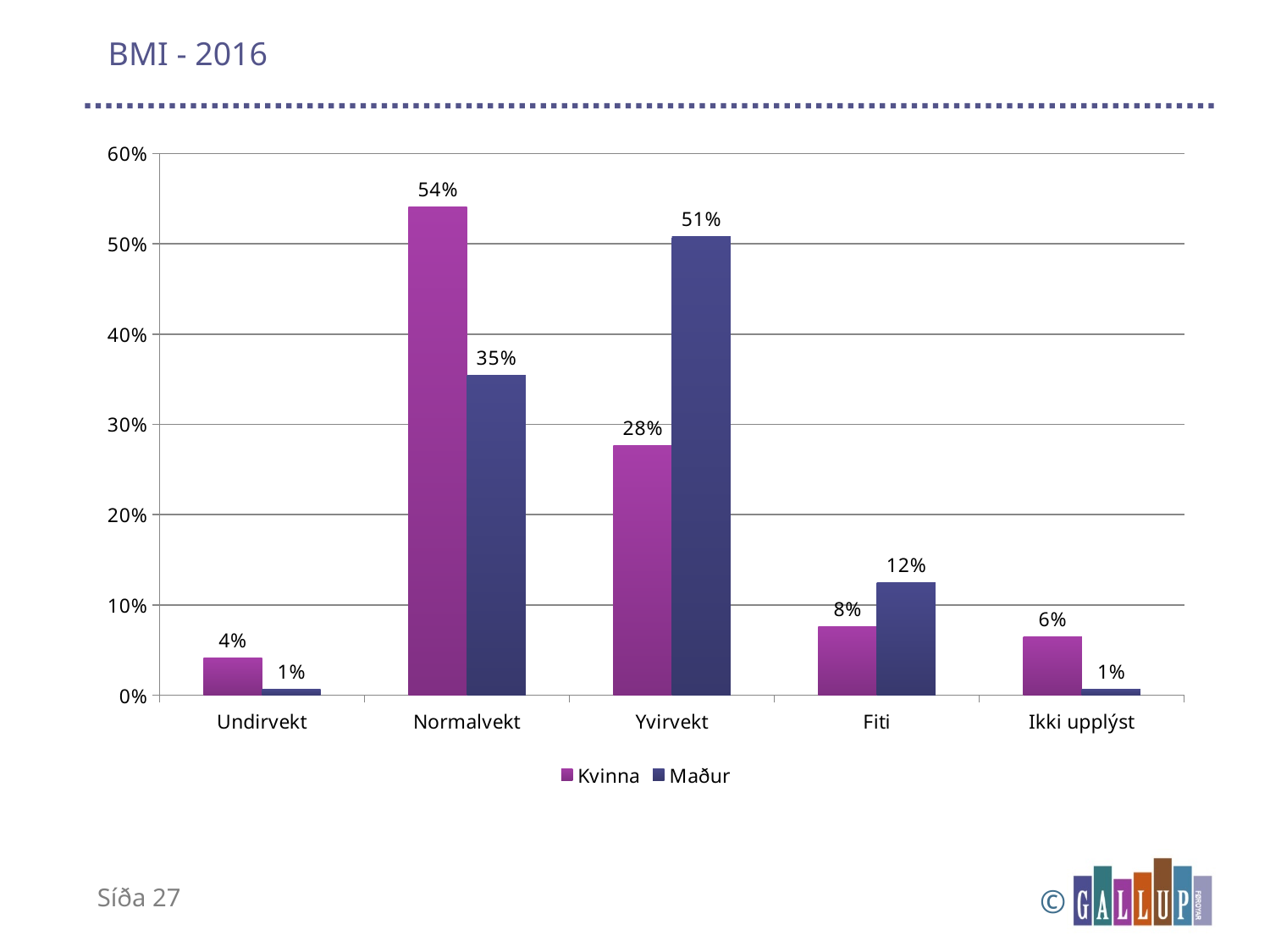
What is the title of the chart? BMI - 2016 In the Yvirvekt category, which series has the larger value, Kvinna or Maður? Maður What is the difference between the Kvinna and Maður values in the Normalvekt category? 19% What is the value for Maður in the Fiti category? 12% What kind of chart is shown on the slide? Bar chart How many categories are shown on the x axis? 5 Which category has the lowest value for Kvinna? Undirvekt How many series does the legend list? 2 What is the value for Kvinna in the Ikki upplýst category? 6% What is the value for Maður in the Yvirvekt category? 51% Which category has the highest value for Kvinna? Normalvekt What is the value for Kvinna in the Normalvekt category? 54%